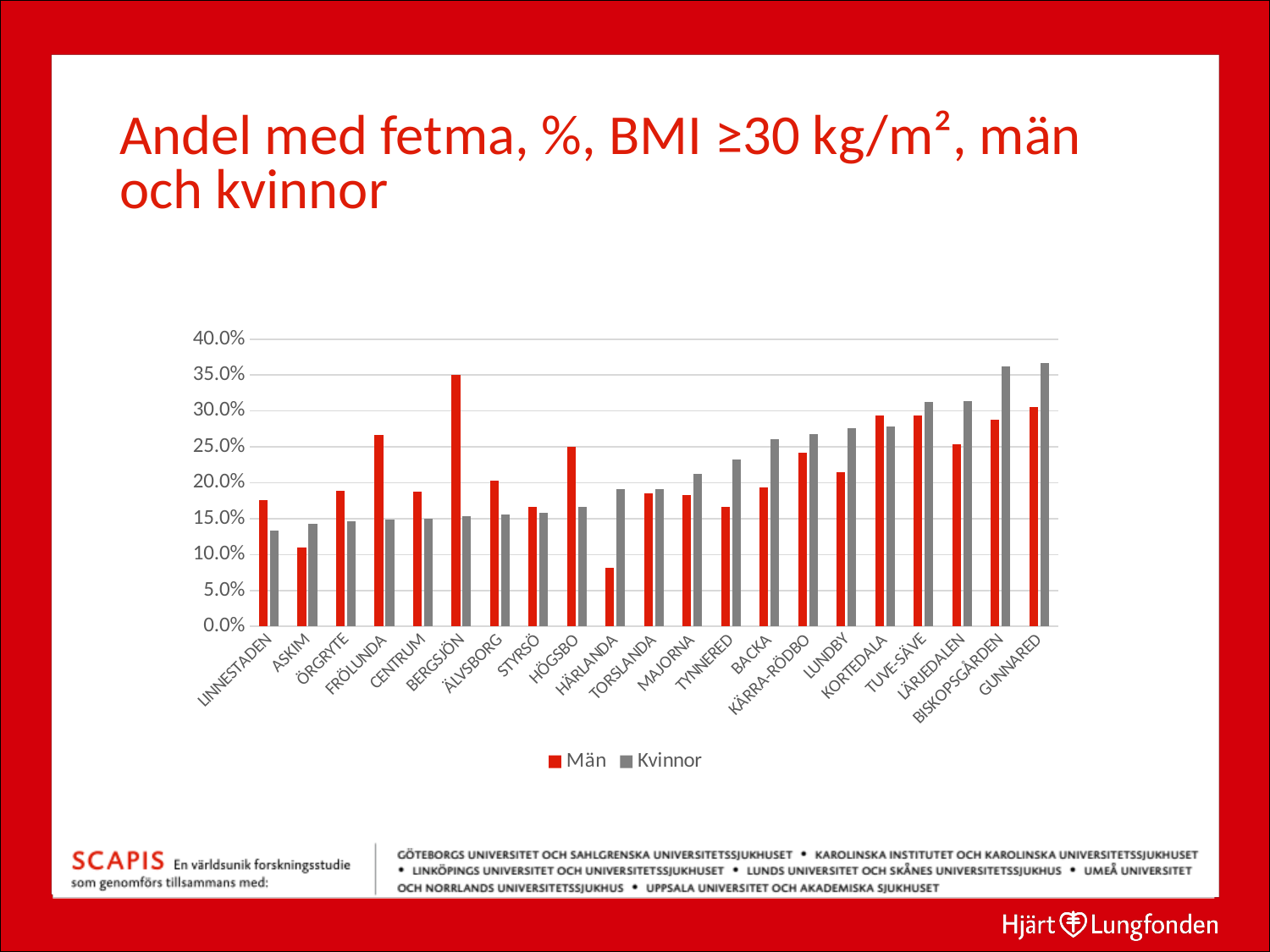
How many districts (categories) are shown on the x axis? 21 What kind of chart is shown on the slide? Bar chart In Gunnared, which is larger: the value for Män or for Kvinnor? Kvinnor Which district has the highest value for Män? Bergsjön In Bergsjön, which is larger: the value for Män or for Kvinnor? Män How many series does the legend list? 2 Is the value for Män in Härlanda greater or less than 10.0%? less Which district has the lowest value for Män? Härlanda Is the value for Kvinnor in Gunnared greater or less than 30.0%? greater Which colour represents Män in the legend? Red Is the value for Män in Askim greater or less than 15.0%? less